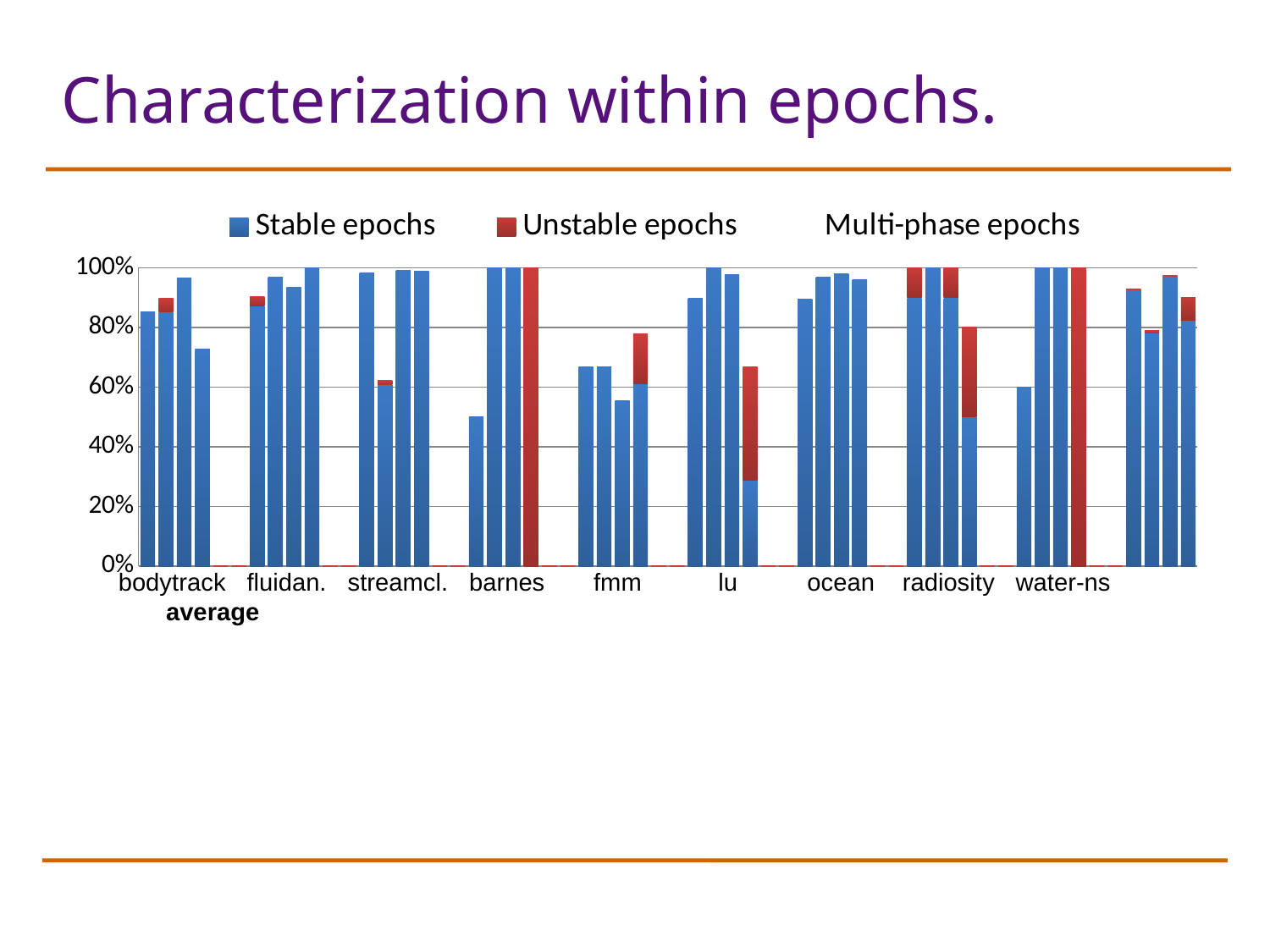
Is the Stable epochs value of the rightmost bar in the lu group greater or less than 40%? less How many series does the chart legend list? 3 Is the Stable epochs value of the rightmost bar in the radiosity group greater or less than 60%? less Which colour represents Stable epochs in the chart? Blue Is the Stable epochs value of the leftmost bar in the water-ns group greater or less than 80%? less How many bars are plotted in the ocean group? 4 What is the title of the slide containing the chart? Characterization within epochs. What kind of chart is shown on the slide? Stacked bar chart